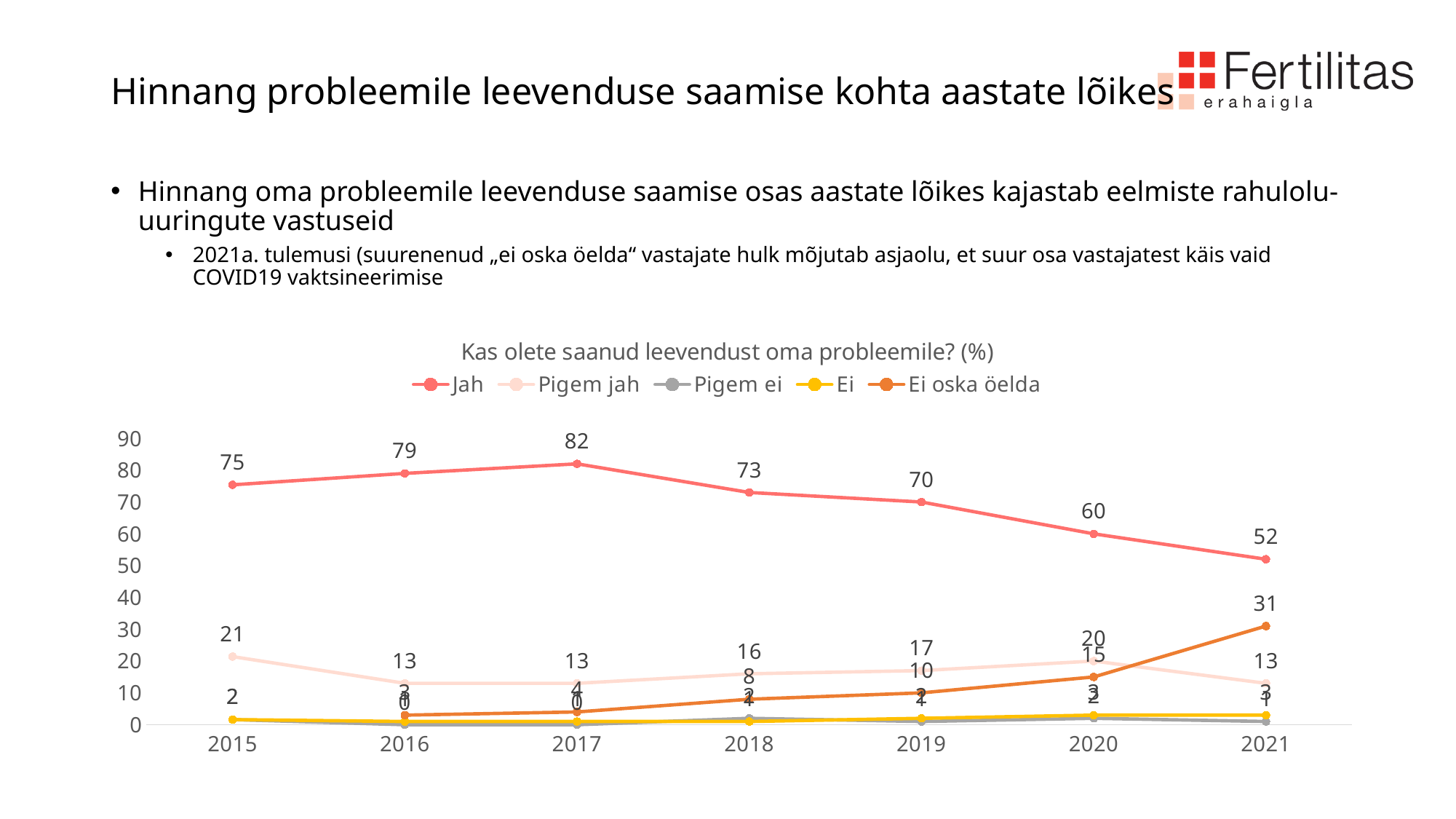
What is the value for Jah in 2017? 82 How many years are shown on the x axis? 7 In 2021, which is larger: Pigem jah or Ei oska öelda? Ei oska öelda What is the value for Jah in 2021? 52 What is the value for Pigem jah in 2015? 21 What is the value for Ei oska öelda in 2021? 31 In which year is the Jah series lowest? 2021 What kind of chart is shown on the slide? line chart In which year is the Jah series highest? 2017 What is the value for Ei oska öelda in 2019? 10 What is the difference between the Jah value in 2017 and in 2021? 30 How many series does the legend list? 5